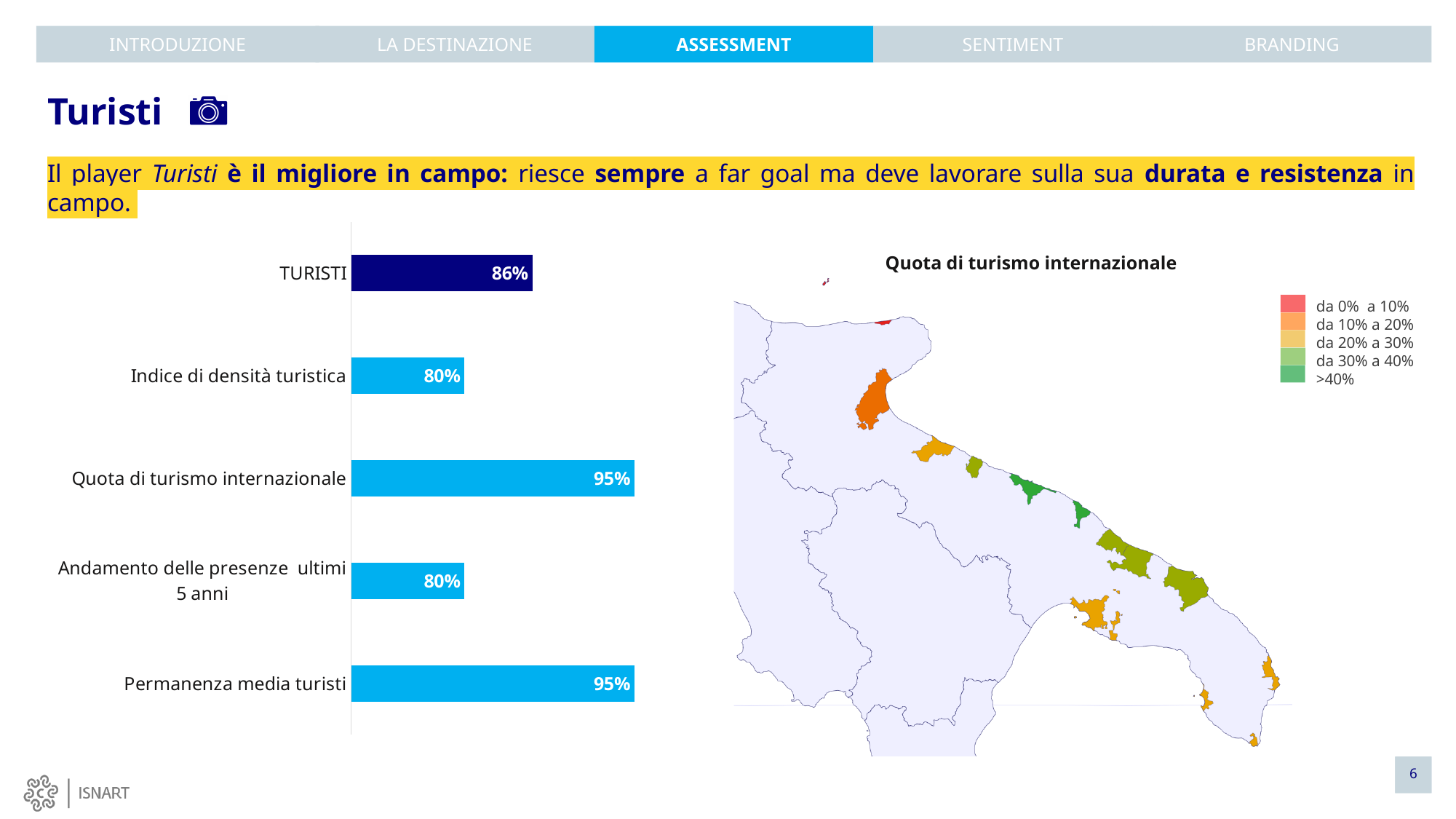
In the bar chart, what is the value for Quota di turismo internazionale? 95% In the bar chart, which is larger: the value for TURISTI or the value for Indice di densità turistica? TURISTI How many classes does the legend of the map titled 'Quota di turismo internazionale' list? 5 In the bar chart, what is the value for Indice di densità turistica? 80% In the bar chart, what is the highest value shown? 95% In the bar chart, what is the value for Andamento delle presenze ultimi 5 anni? 80% In the bar chart, what is the difference between the value for Quota di turismo internazionale and the value for TURISTI? 9% In the bar chart, what is the value for TURISTI? 86% In the bar chart, what is the lowest value shown? 80% In the bar chart, what is the value for Permanenza media turisti? 95% How many categories does the bar chart on the left show? 5 What kind of chart is shown on the left of the slide? bar chart